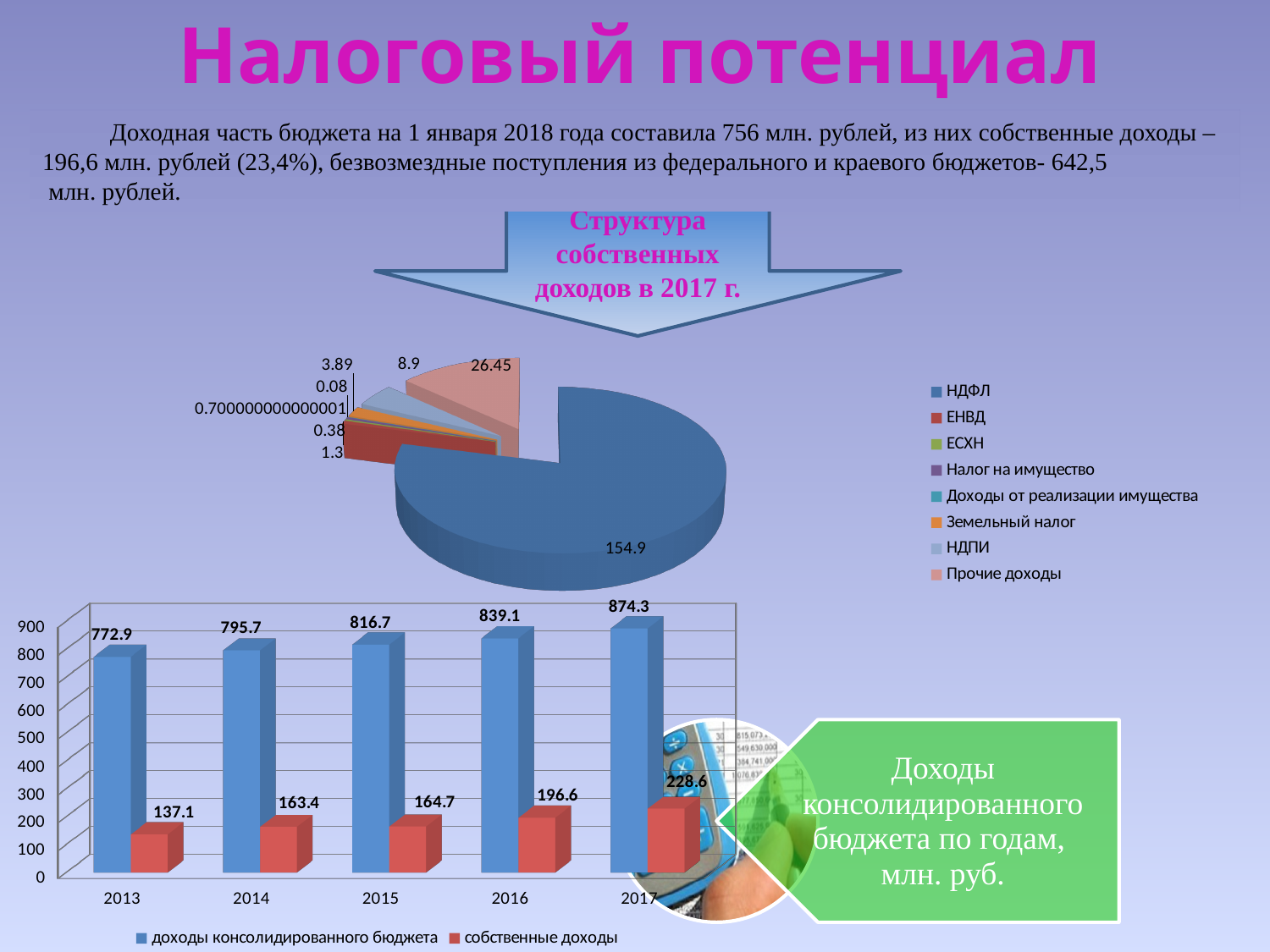
In the bar chart 'Доходы консолидированного бюджета по годам, млн. руб.', what is the value of собственные доходы for 2017? 228.6 In the bar chart 'Доходы консолидированного бюджета по годам, млн. руб.', which year has the highest доходы консолидированного бюджета? 2017 How many series does the legend of the bar chart 'Доходы консолидированного бюджета по годам, млн. руб.' list? 2 In the bar chart 'Доходы консолидированного бюджета по годам, млн. руб.', do the values of собственные доходы rise or fall from 2013 to 2017? rise In the bar chart 'Доходы консолидированного бюджета по годам, млн. руб.', what is the difference between доходы консолидированного бюджета in 2017 and in 2013? 101.4 How many years are shown on the x axis of the bar chart 'Доходы консолидированного бюджета по годам, млн. руб.'? 5 In the pie chart 'Структура собственных доходов в 2017 г.', what is the value for НДФЛ? 154.9 In the pie chart 'Структура собственных доходов в 2017 г.', which category has the largest slice? НДФЛ In the bar chart 'Доходы консолидированного бюджета по годам, млн. руб.', which year has the lowest собственные доходы? 2013 In the bar chart 'Доходы консолидированного бюджета по годам, млн. руб.', which is larger: собственные доходы in 2014 or in 2015? 2015 In the bar chart 'Доходы консолидированного бюджета по годам, млн. руб.', what is the value of доходы консолидированного бюджета for 2015? 816.7 What kind of chart is the chart 'Доходы консолидированного бюджета по годам, млн. руб.'? bar chart